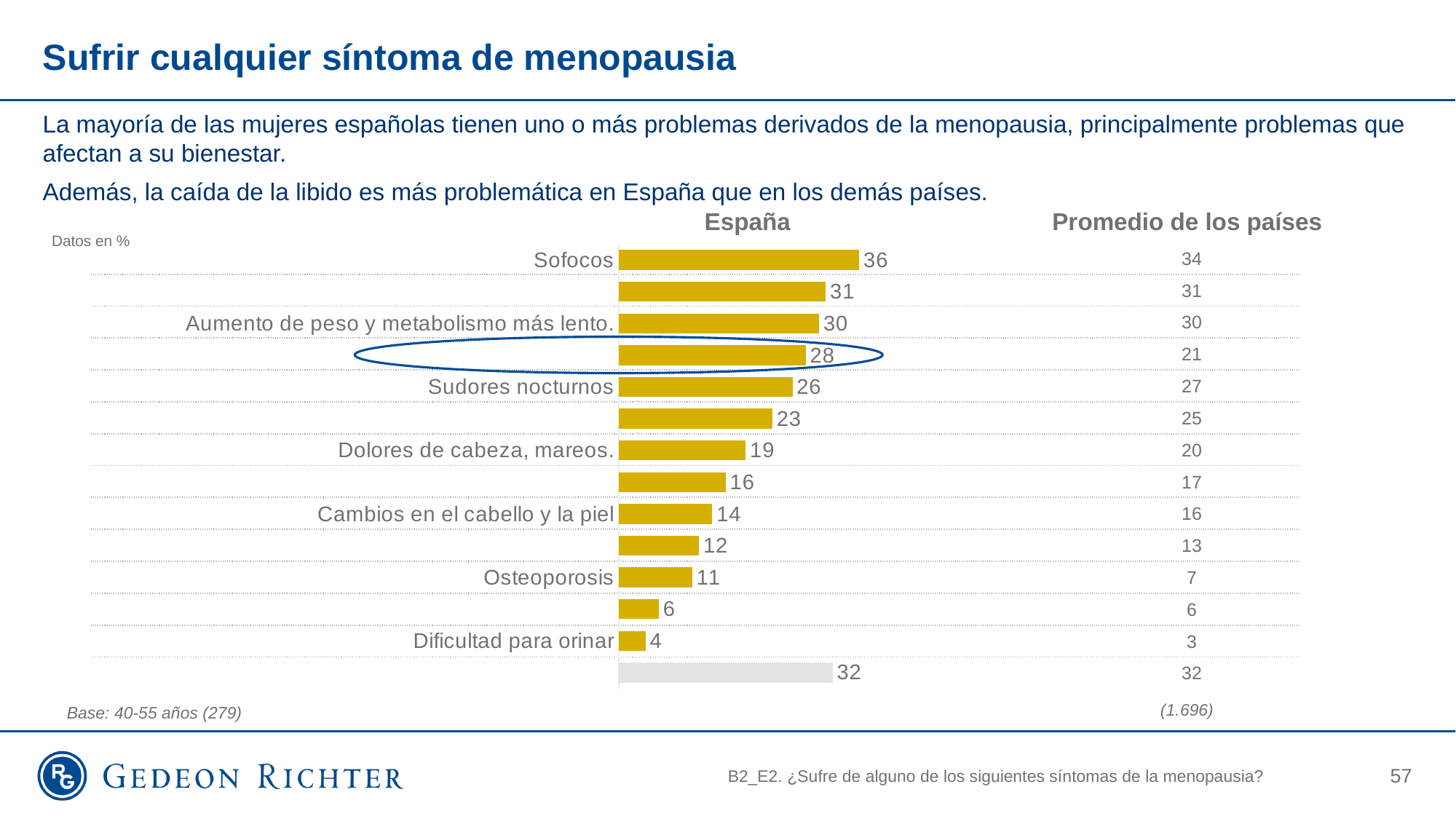
What is the value for Sofocos in the España bar chart? 36 What kind of chart is shown on the slide? Bar chart How many bars are plotted in the España chart? 14 Which labelled category has the highest value in the España bar chart? Sofocos What is the difference between the España value and the Promedio de los países value for Osteoporosis? 4 Which labelled category has the lowest value in the España bar chart? Dificultad para orinar What is the value for Osteoporosis in the España bar chart? 11 What is the difference between the España values for Sofocos and Sudores nocturnos? 10 In what unit are the data in the chart expressed, according to the note at the top left? % What is the value for Dolores de cabeza, mareos. in the España bar chart? 19 What is the Promedio de los países value for Sofocos? 34 Which has a larger España value, Osteoporosis or Cambios en el cabello y la piel? Cambios en el cabello y la piel